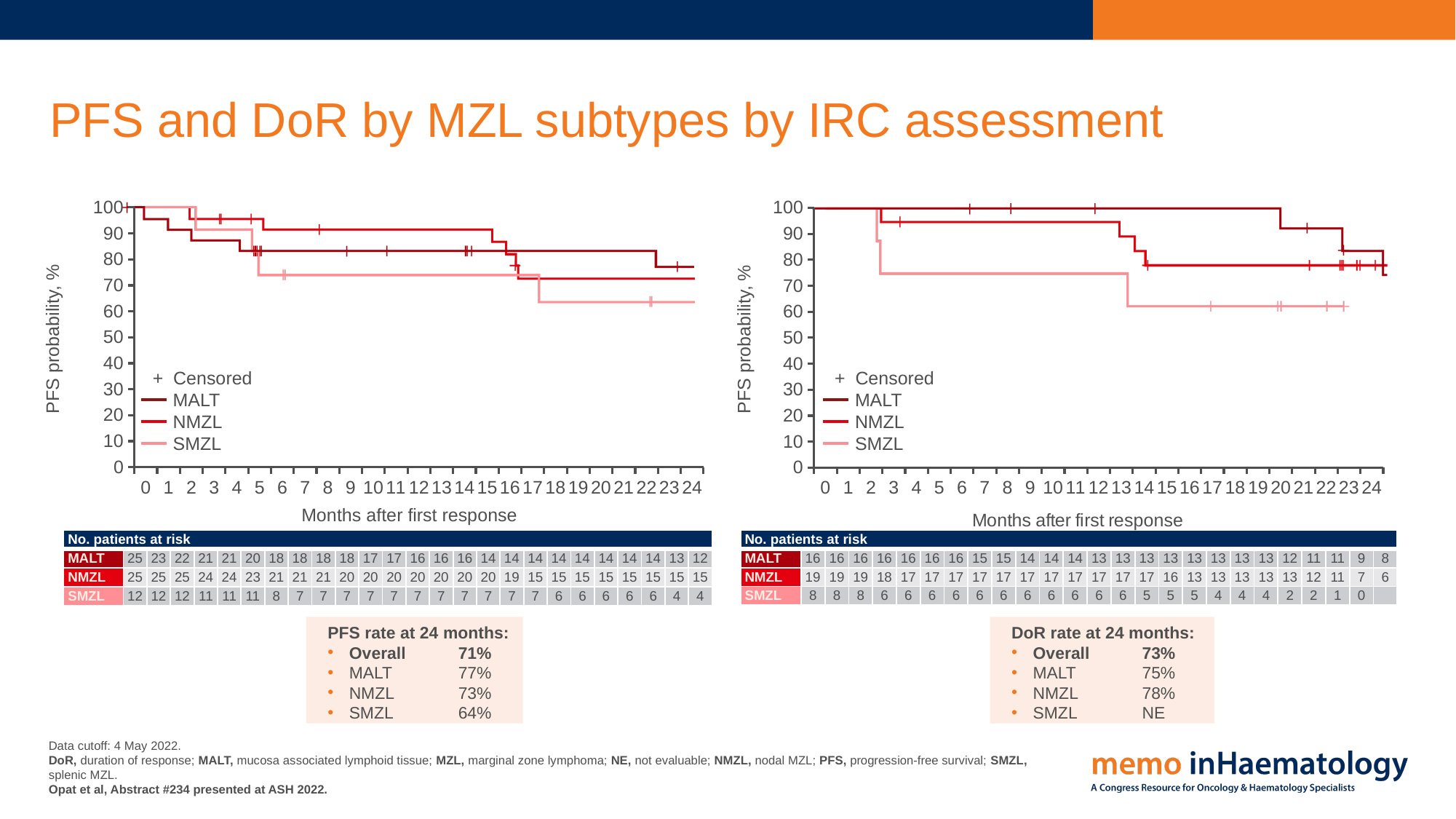
On the left chart, is the SMZL curve at month 20 greater or less than 70? less How many subtype series does the legend of the left chart list (excluding the censored marker)? 3 On the right chart, which is larger, the DoR rate at 24 months for MALT or for NMZL? NMZL On the right chart, how many patients with MALT were at risk at month 24? 8 On the left chart, what is the PFS rate at 24 months for MALT? 77% On the left chart, which subtype has the highest PFS rate at 24 months? MALT On the left chart, what is the PFS rate at 24 months for SMZL? 64% On the right chart, what is the DoR rate at 24 months for NMZL? 78% On the left chart, what is the difference between the PFS rate at 24 months for MALT and for SMZL? 13% On the left chart, which subtype has the lowest PFS rate at 24 months? SMZL On the right chart, what is the DoR rate at 24 months for SMZL? NE On the left chart, how many patients with SMZL were at risk at month 0? 12